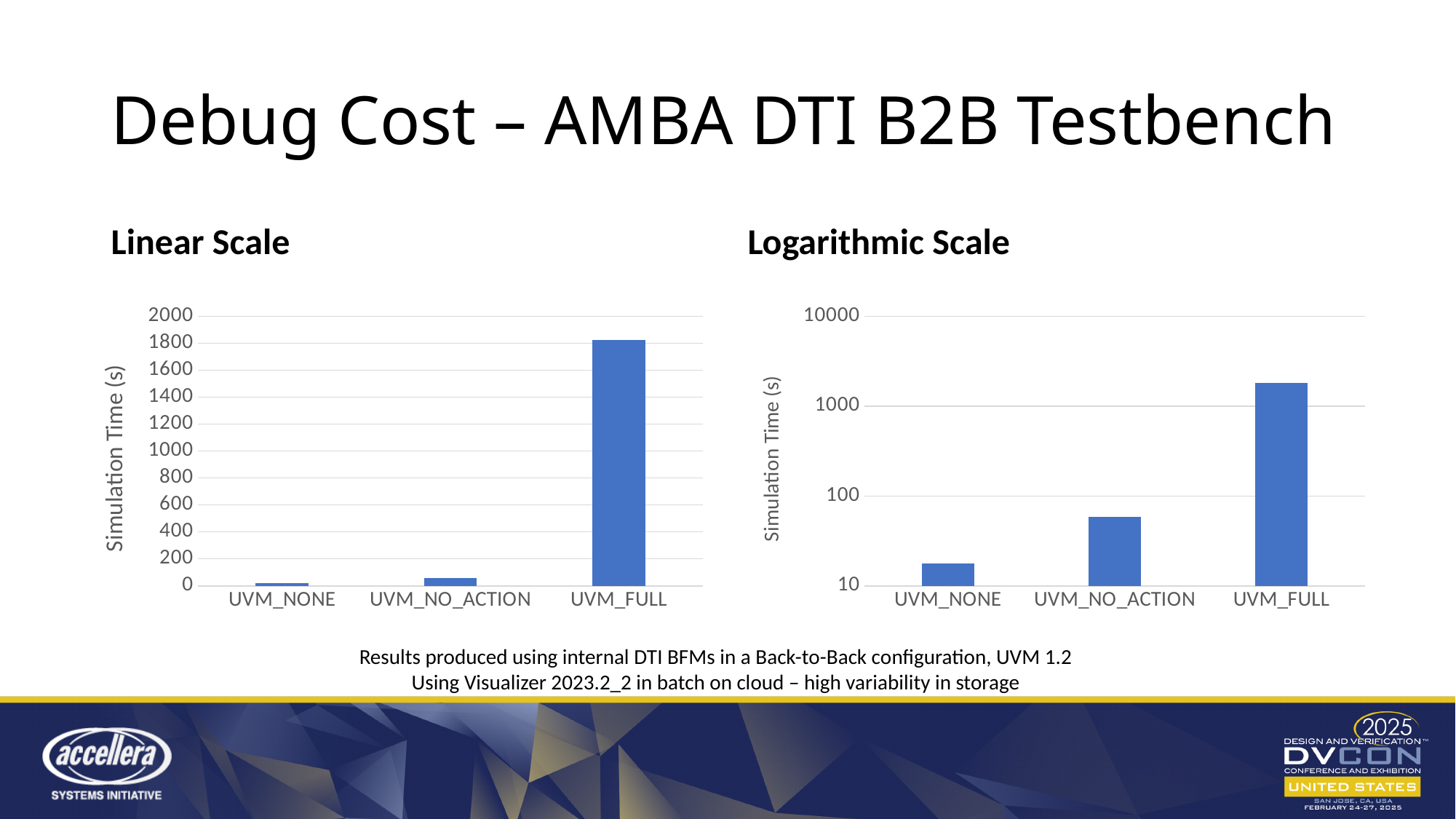
In the Linear Scale chart, which category has the highest simulation time? UVM_FULL In the Linear Scale chart, is the value for UVM_FULL greater or less than 1600? greater In the Logarithmic Scale chart, what is the label on the y axis? Simulation Time (s) In the Linear Scale chart, do the values rise or fall from UVM_NONE to UVM_FULL along the x axis? rise In the Logarithmic Scale chart, is the value for UVM_NO_ACTION greater or less than 100? less In the Logarithmic Scale chart, which is larger, the value for UVM_NONE or the value for UVM_NO_ACTION? UVM_NO_ACTION In the Logarithmic Scale chart, which category has the lowest simulation time? UVM_NONE In the Logarithmic Scale chart, is the value for UVM_FULL greater or less than 1000? greater In the Linear Scale chart, how many categories are plotted on the x axis? 3 In the Linear Scale chart, what kind of chart is shown? bar chart In the Logarithmic Scale chart, what is the highest tick value shown on the y axis? 10000